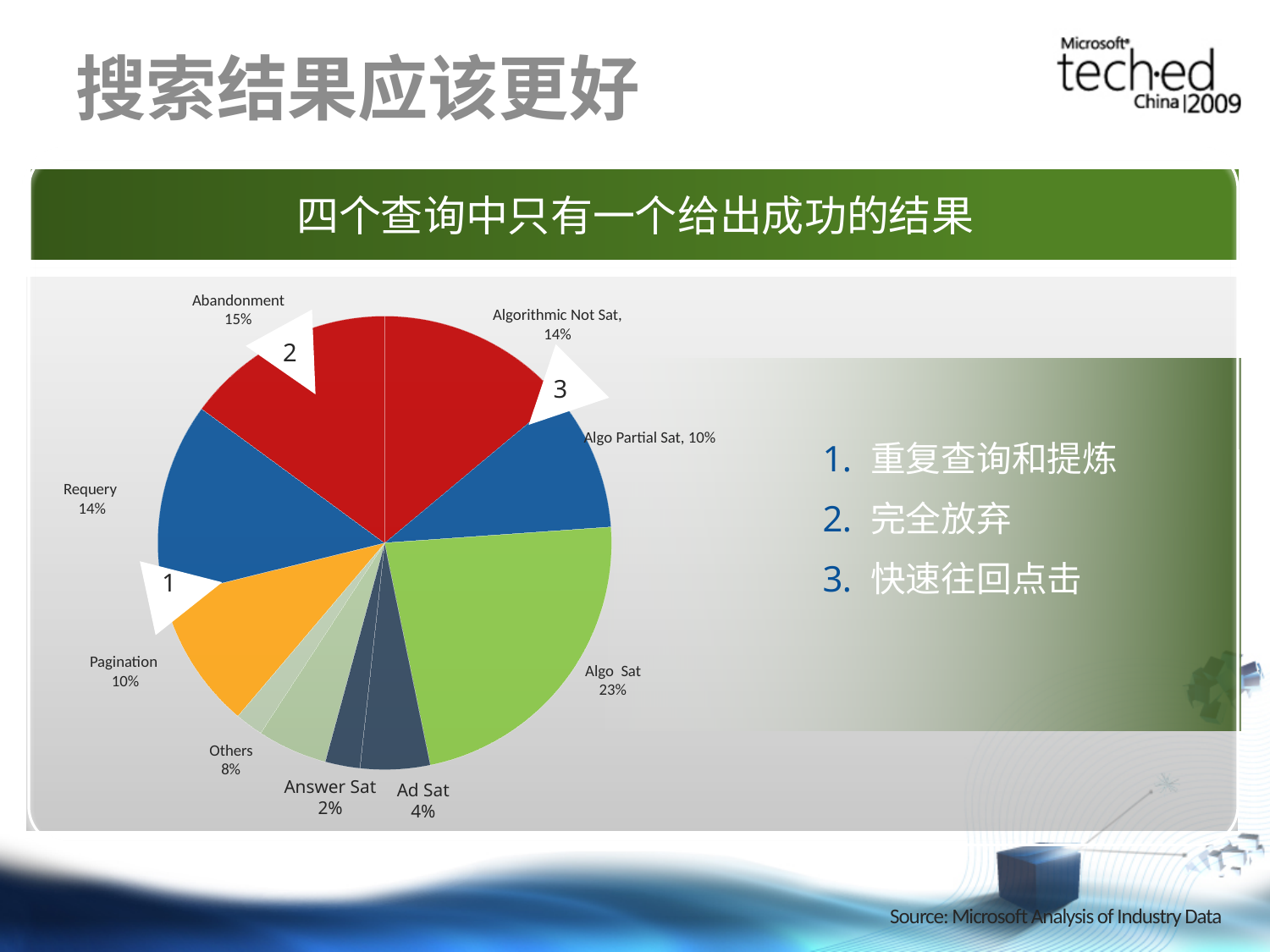
What is the difference between the Algo Sat share and the Abandonment share? 8% Which slice of the pie is the largest? Algo Sat What is the value shown for Abandonment? 15% Which is larger, the Ad Sat slice or the Answer Sat slice? Ad Sat How many slices does the pie chart have? 10 What is the combined share of Algorithmic Not Sat and Requery? 28% What source is cited for the chart data at the bottom of the slide? Microsoft Analysis of Industry Data What is the value shown for Pagination? 10% What kind of chart is shown on the slide? pie chart Which slice of the pie is the smallest? Answer Sat What is the value shown for Others? 8% What share of the pie does Algo Sat represent? 23%